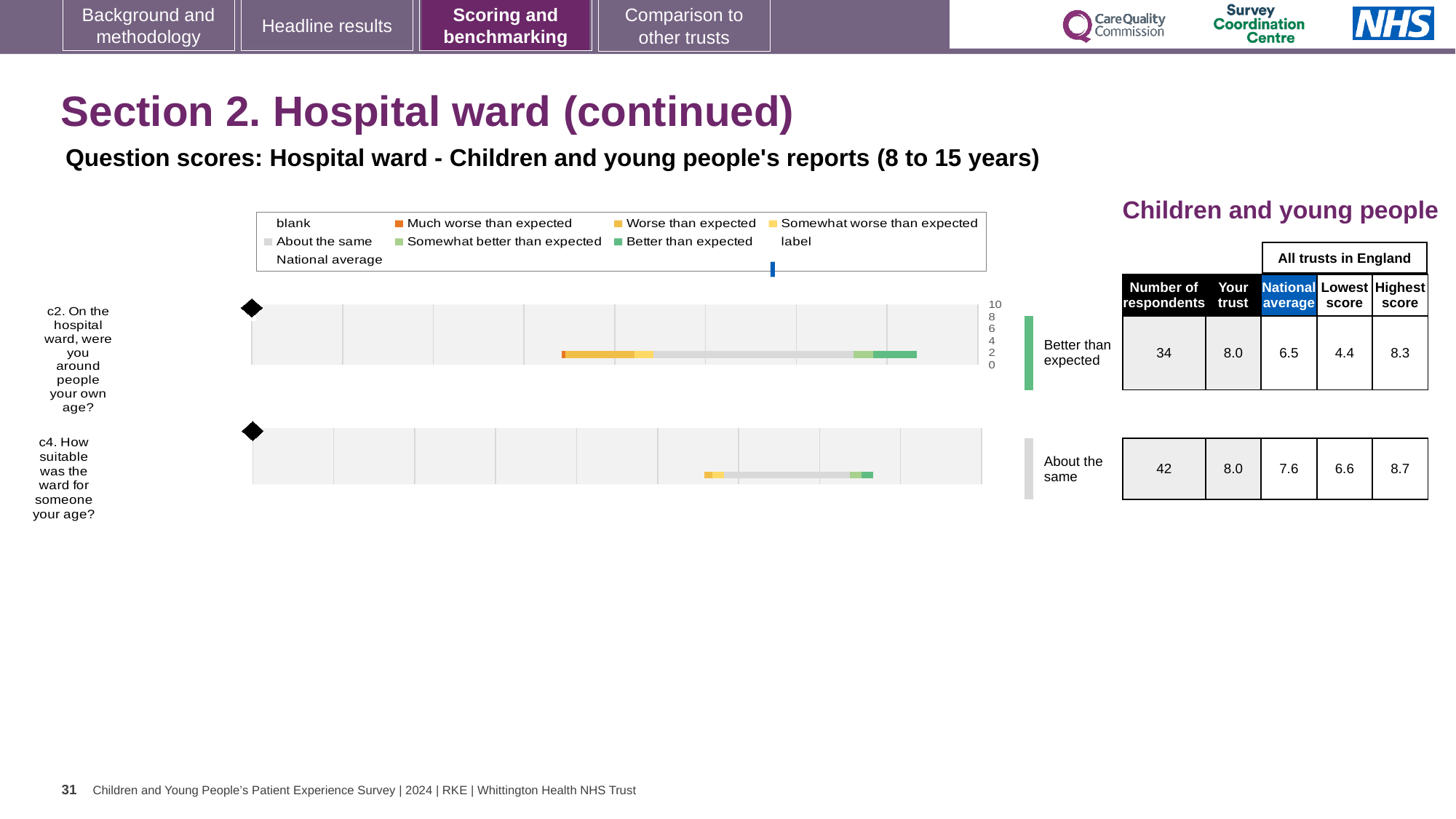
For c4, which is larger: the trust's score or the national average? Your trust What kind of chart is used to show the question scores for c2 and c4? bar chart What is the national average score for c4 (How suitable was the ward for someone your age?)? 7.6 What benchmark category is shown next to the c2 bar? Better than expected What is the lowest score across all trusts in England for c2? 4.4 Which question had more respondents, c2 or c4? c4 What benchmark category is shown next to the c4 bar? About the same How many respondents answered c2? 34 By how much does the trust's score for c2 exceed the national average for c2? 1.5 What is the 'Your trust' score for c2 (On the hospital ward, were you around people your own age?)? 8.0 What is the highest score across all trusts in England for c4? 8.7 How many questions (rows) are plotted on the slide? 2